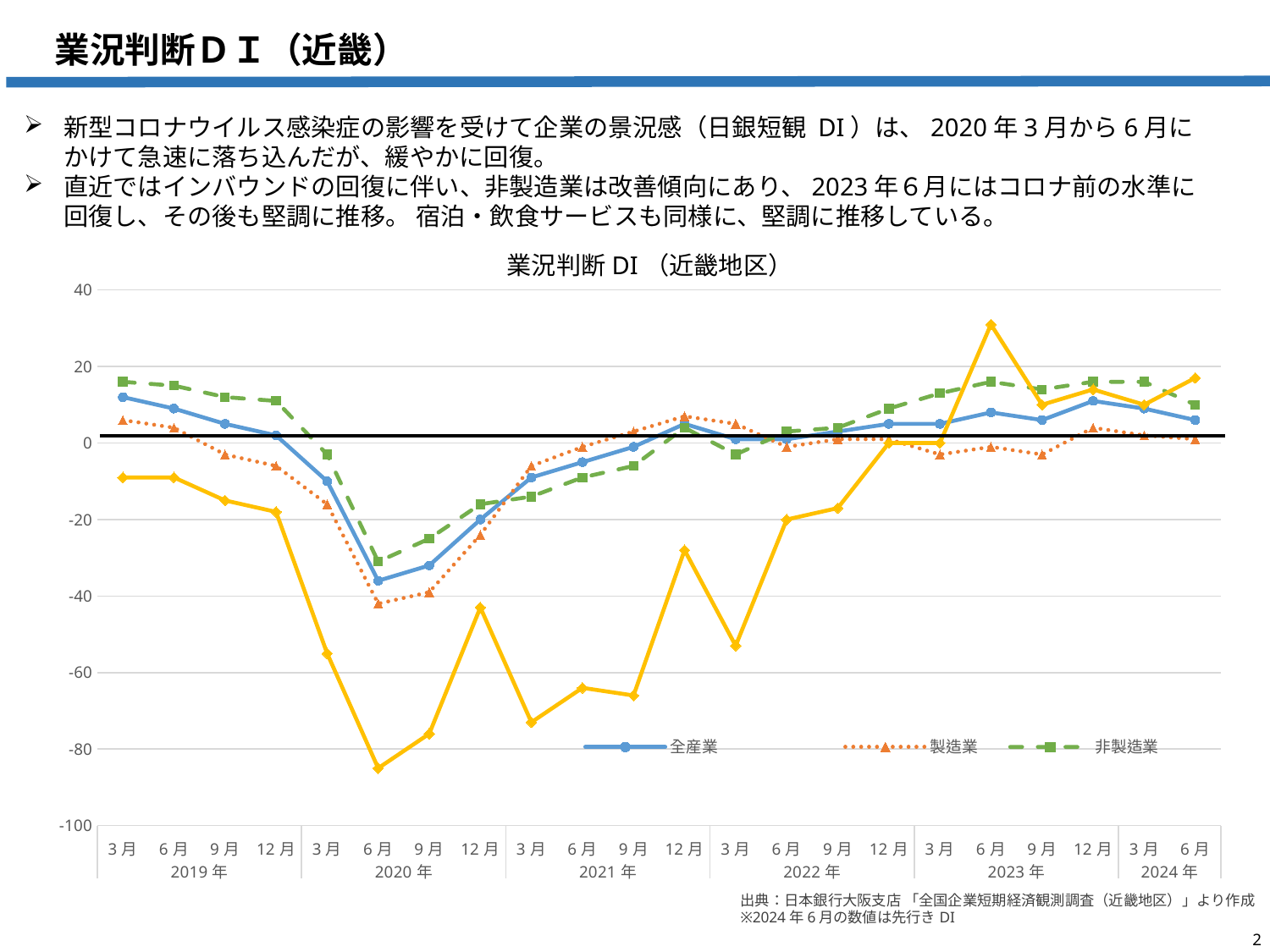
At which time point does 全産業 reach its lowest value? 2020年6月 In 2020年6月, which is lower, 製造業 or 非製造業? 製造業 Is the value for 非製造業 in 2023年6月 greater or less than 0? greater What kind of chart is shown on the slide? line chart What is the title of the chart? 業況判断DI（近畿地区） How many series does the chart legend list? 3 Is the value for 全産業 in 2020年6月 greater or less than -20? less How many time points are plotted along the x axis? 22 Does the 全産業 line rise or fall from 2019年3月 to 2020年6月? fall Is the value for 全産業 in 2019年3月 greater or less than 0? greater Which series is drawn as a green dashed line with square markers? 非製造業